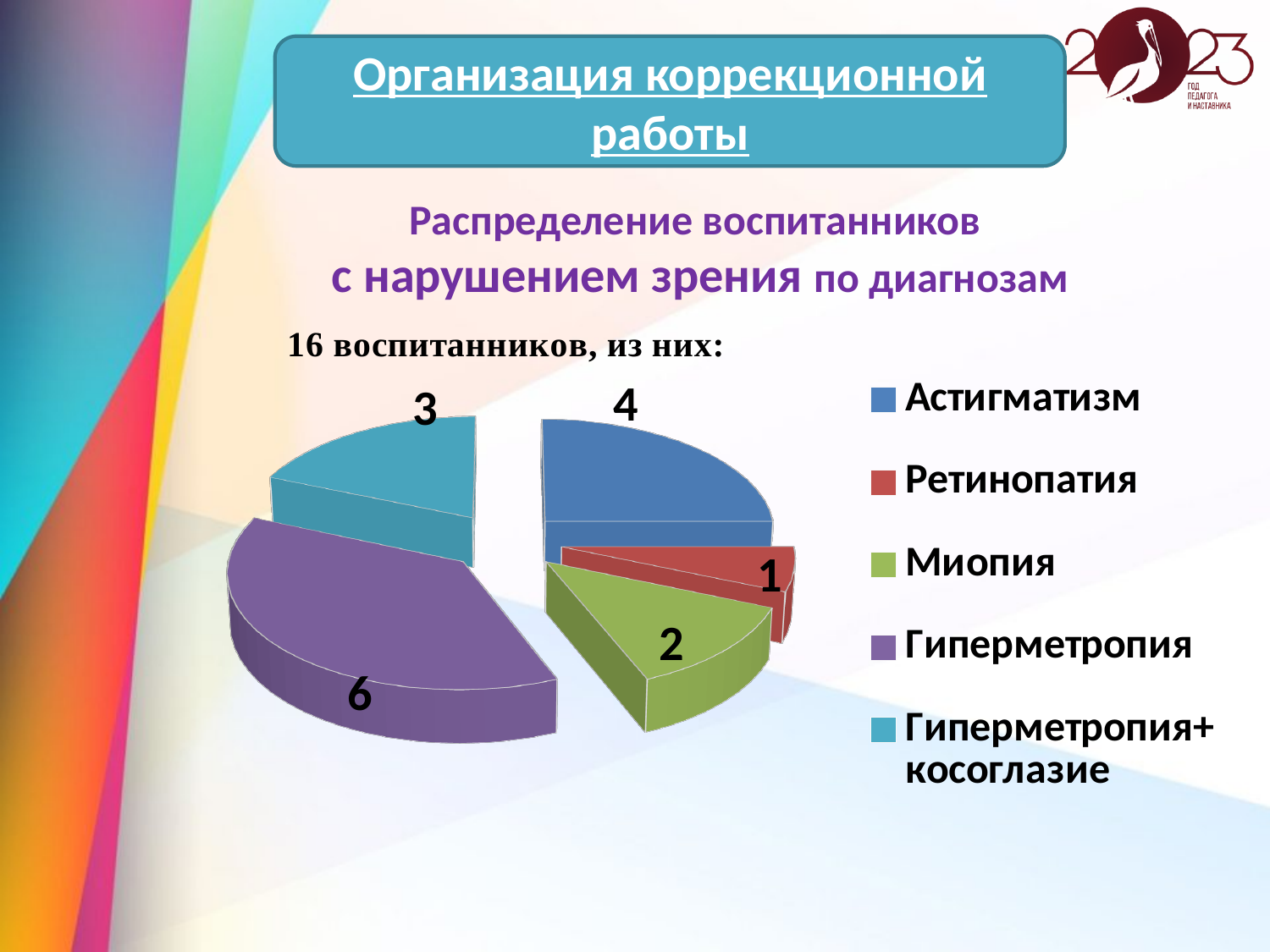
How many slices does the pie chart have? 5 What is the difference between the Гиперметропия and Астигматизм values? 2 How many pupils are in the Астигматизм slice? 4 Which diagnosis has the largest slice of the pie? Гиперметропия What is the value shown for Миопия? 2 What is the value of the Гиперметропия slice? 6 What colour is the Миопия slice in the legend? green What is the value shown for Ретинопатия? 1 What is the value of the Гиперметропия+косоглазие slice? 3 What kind of chart is shown on the slide? pie chart Which is larger, the Миопия slice or the Гиперметропия+косоглазие slice? Гиперметропия+косоглазие Which diagnosis has the smallest slice of the pie? Ретинопатия